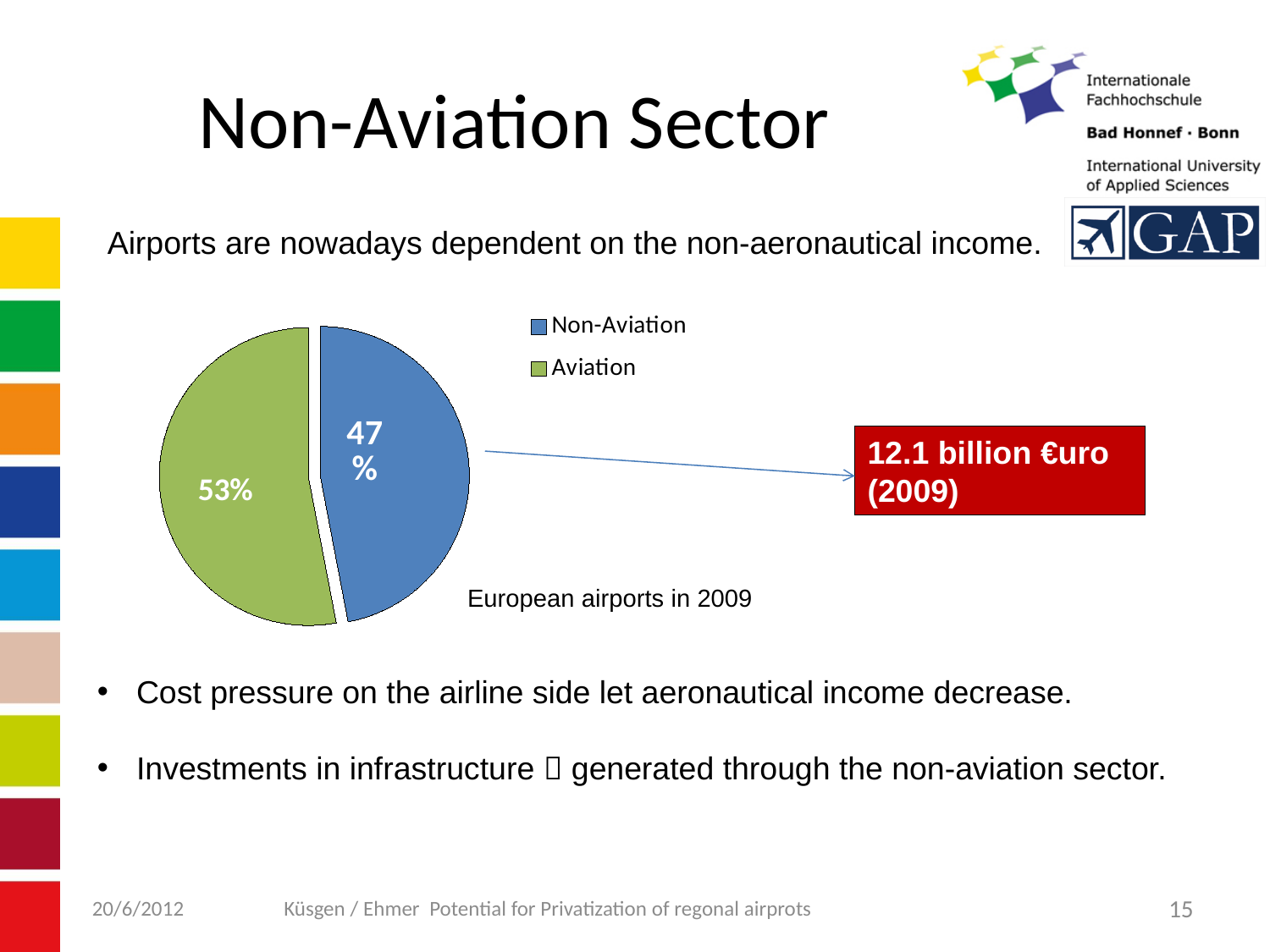
How many entries does the legend list? 2 Which slice of the pie is the largest? Aviation Is the Non-Aviation share greater or less than 50%? less What value does the red box linked to the Non-Aviation slice show? 12.1 billion €uro (2009) What colour is the Non-Aviation slice? blue Which is larger, the Aviation slice or the Non-Aviation slice? Aviation What share of the pie does Non-Aviation represent? 47% Which slice of the pie is the smallest? Non-Aviation What is the difference in percentage points between the Aviation and Non-Aviation slices? 6 percentage points What share of the pie does Aviation represent? 53% What kind of chart is shown on the slide? pie chart How many slices does the pie chart have? 2